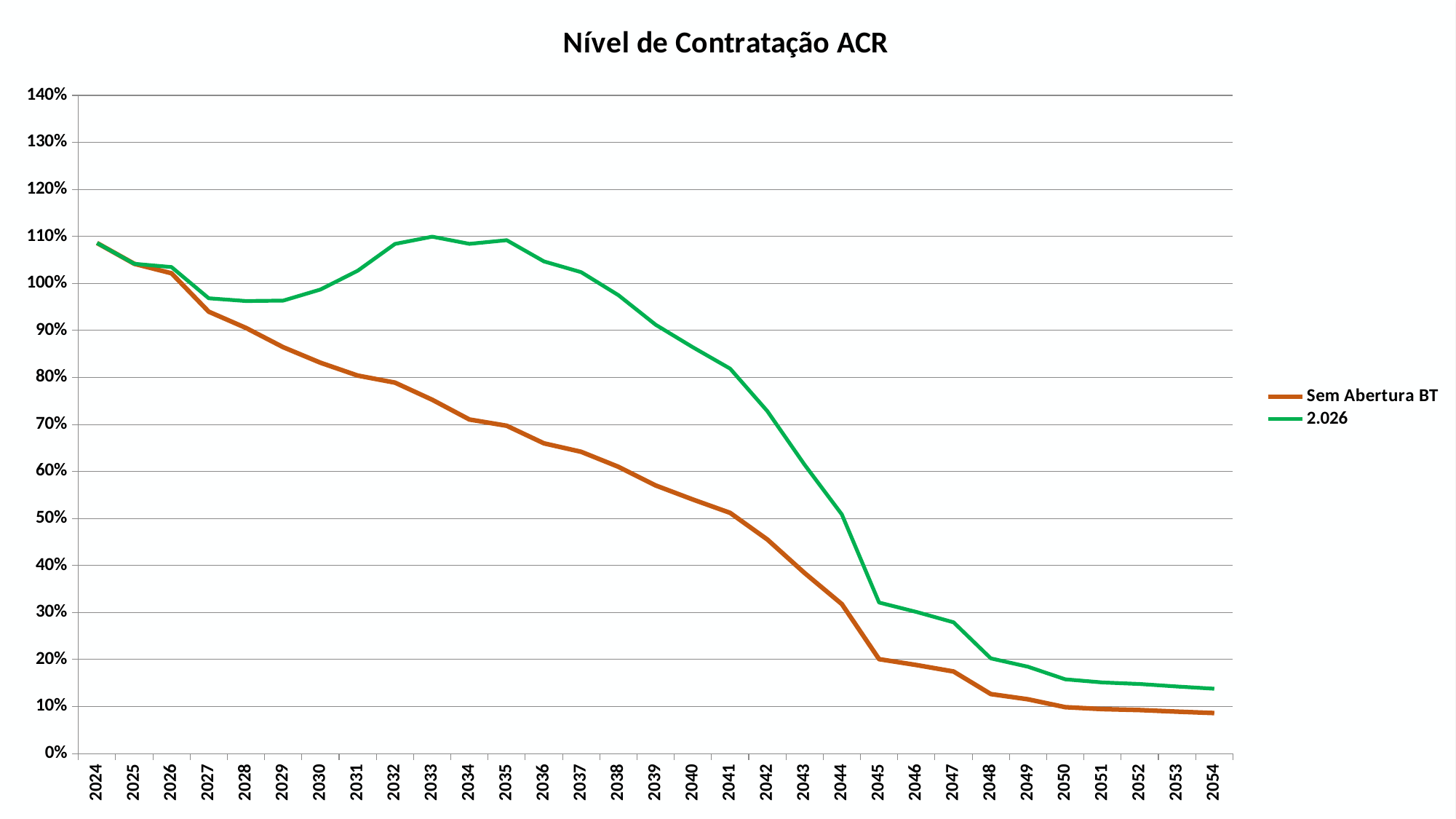
Does the value for Sem Abertura BT rise or fall from 2024 to 2054? fall How many years are plotted along the x axis? 31 For the series 2.026, is the value in 2030 larger or smaller than the value in 2040? larger In 2040, which series has the higher value, Sem Abertura BT or 2.026? 2.026 What colour is the line for the series 2.026? green How many series does the legend list? 2 Is the value for Sem Abertura BT in 2045 greater or less than 30%? less What is the title of the chart? Nível de Contratação ACR Is the value for Sem Abertura BT in 2024 greater or less than 100%? greater Is the value for 2.026 in 2054 greater or less than 20%? less What kind of chart is shown on the slide? line chart